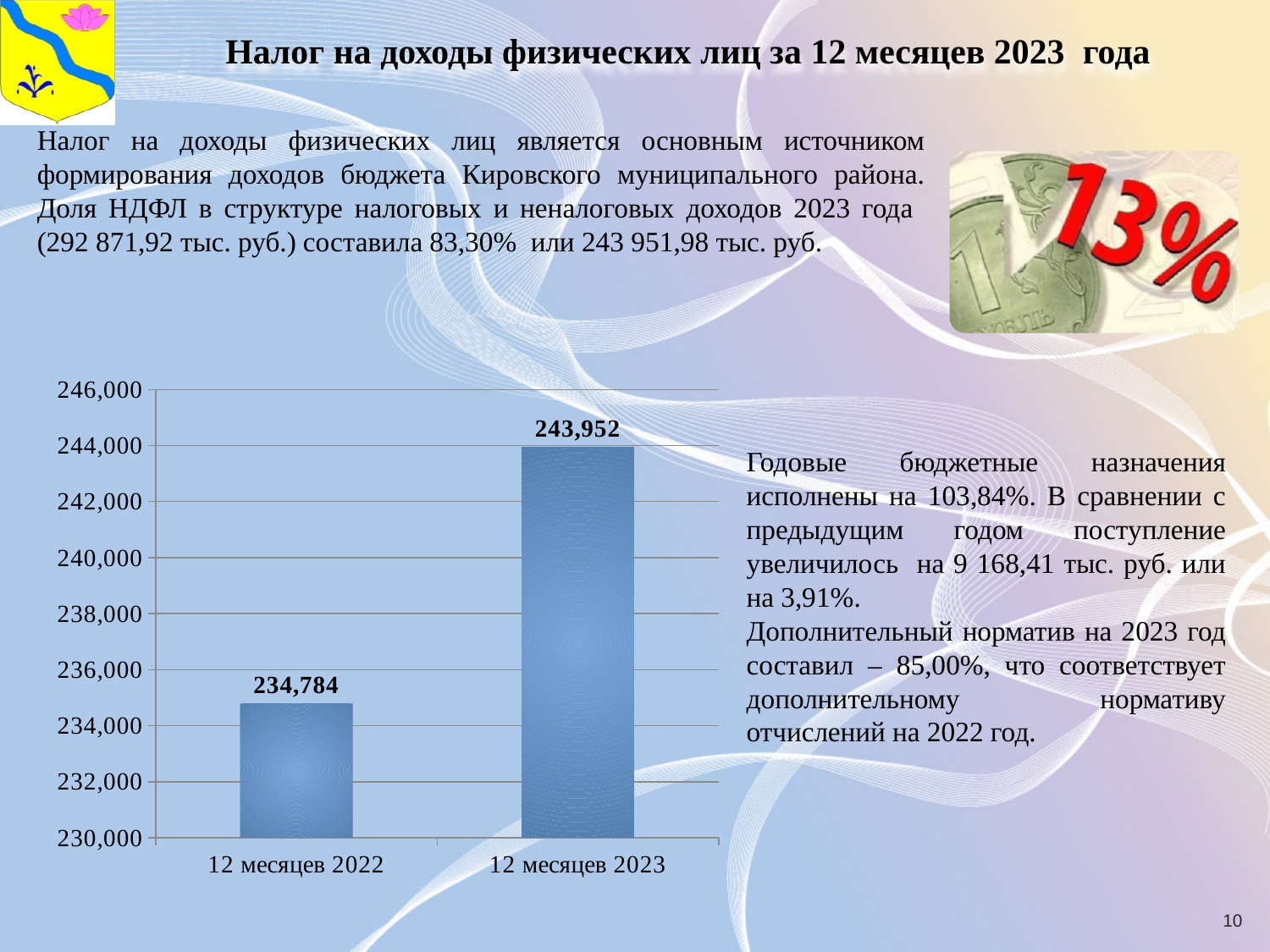
Which category has the highest value? 12 месяцев 2023 What is the difference between the values for 12 месяцев 2023 and 12 месяцев 2022? 9,168 Do the values rise or fall from 12 месяцев 2022 to 12 месяцев 2023? rise What kind of chart is shown on the slide? bar chart What is the value for 12 месяцев 2022? 234,784 Which is larger, the value for 12 месяцев 2022 or for 12 месяцев 2023? 12 месяцев 2023 Is the value for 12 месяцев 2022 greater or less than 236,000? less What is the value for 12 месяцев 2023? 243,952 Which category has the lowest value? 12 месяцев 2022 How many categories are shown on the x axis of the chart? 2 Is the value for 12 месяцев 2023 greater or less than 242,000? greater What is the lowest value shown on the chart's vertical axis? 230,000